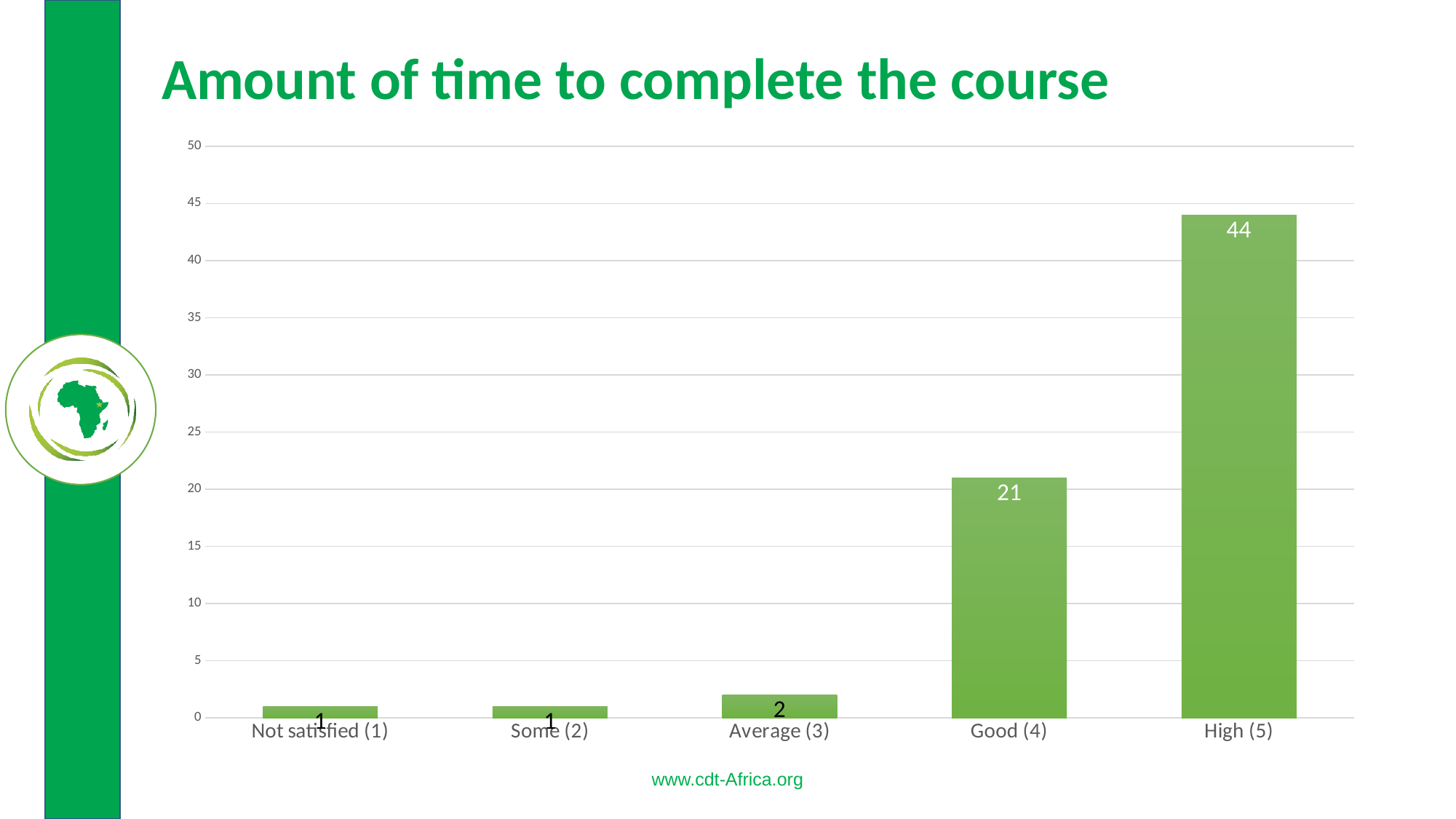
Is the value for High (5) greater or less than 40? greater What is the value for High (5)? 44 What is the value for Average (3)? 2 Do the values rise or fall from Not satisfied (1) to High (5)? rise What is the difference between the values for High (5) and Good (4)? 23 What kind of chart is shown on the slide? bar chart What is the value for Not satisfied (1)? 1 Which is larger, the value for Good (4) or the value for Average (3)? Good (4) How many categories are shown on the x axis? 5 What is the value for Good (4)? 21 Which category has the highest value? High (5) What is the title of the chart? Amount of time to complete the course